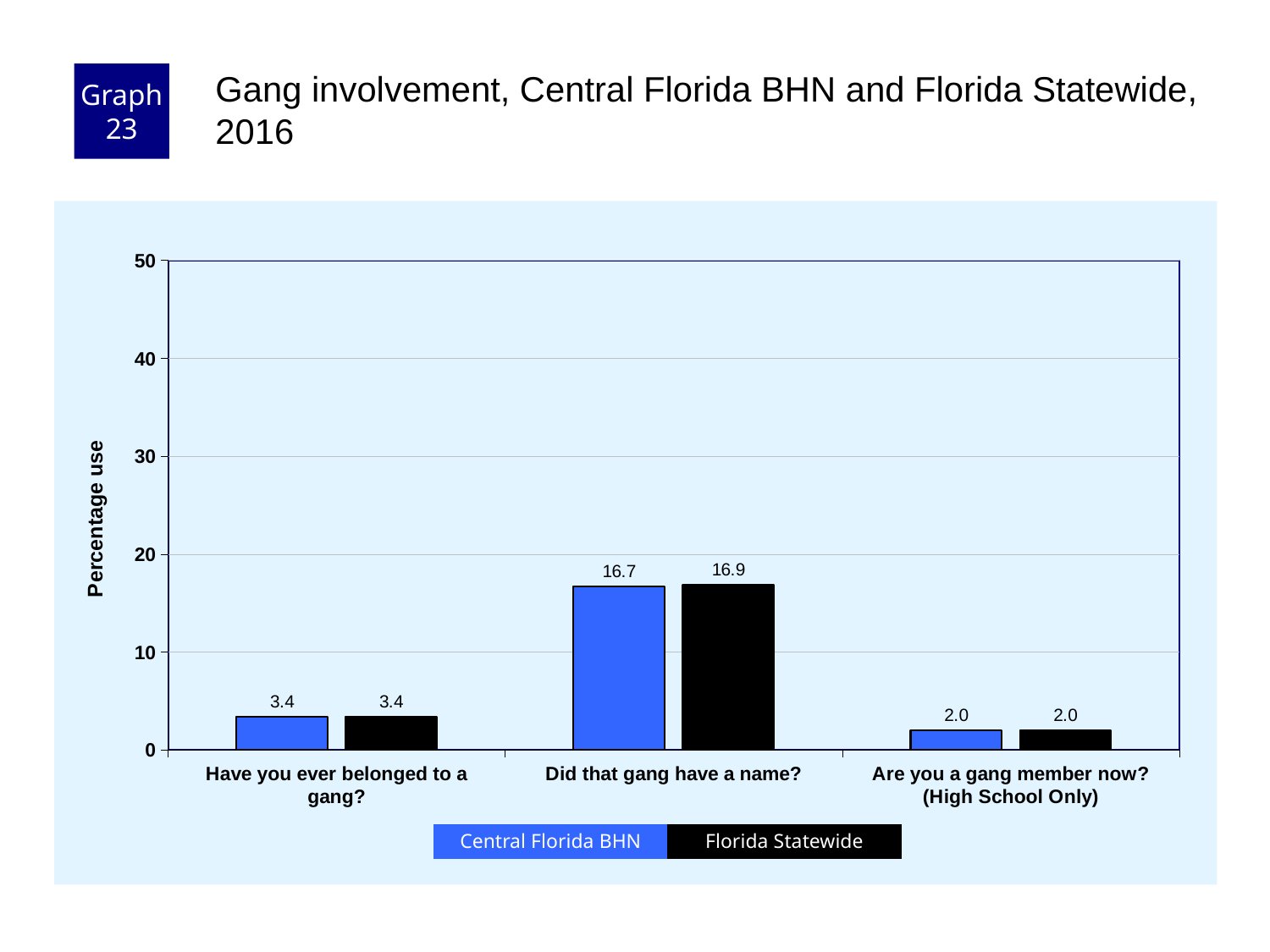
What is the difference between the Florida Statewide and Central Florida BHN values for "Did that gang have a name?"? 0.2 What kind of chart is shown on the slide? bar chart Which question has the highest Central Florida BHN value? Did that gang have a name? What is the Central Florida BHN value for "Did that gang have a name?"? 16.7 What is the difference between the Central Florida BHN values for "Did that gang have a name?" and "Have you ever belonged to a gang?"? 13.3 How many questions (categories) are shown on the x axis? 3 What is the Florida Statewide value for "Did that gang have a name?"? 16.9 What is the Florida Statewide value for "Are you a gang member now? (High School Only)"? 2.0 Is the Central Florida BHN value for "Did that gang have a name?" greater or less than 20? less Which question has the lowest Florida Statewide value? Are you a gang member now? (High School Only) How many series does the legend list? 2 What is the Central Florida BHN value for "Have you ever belonged to a gang?"? 3.4